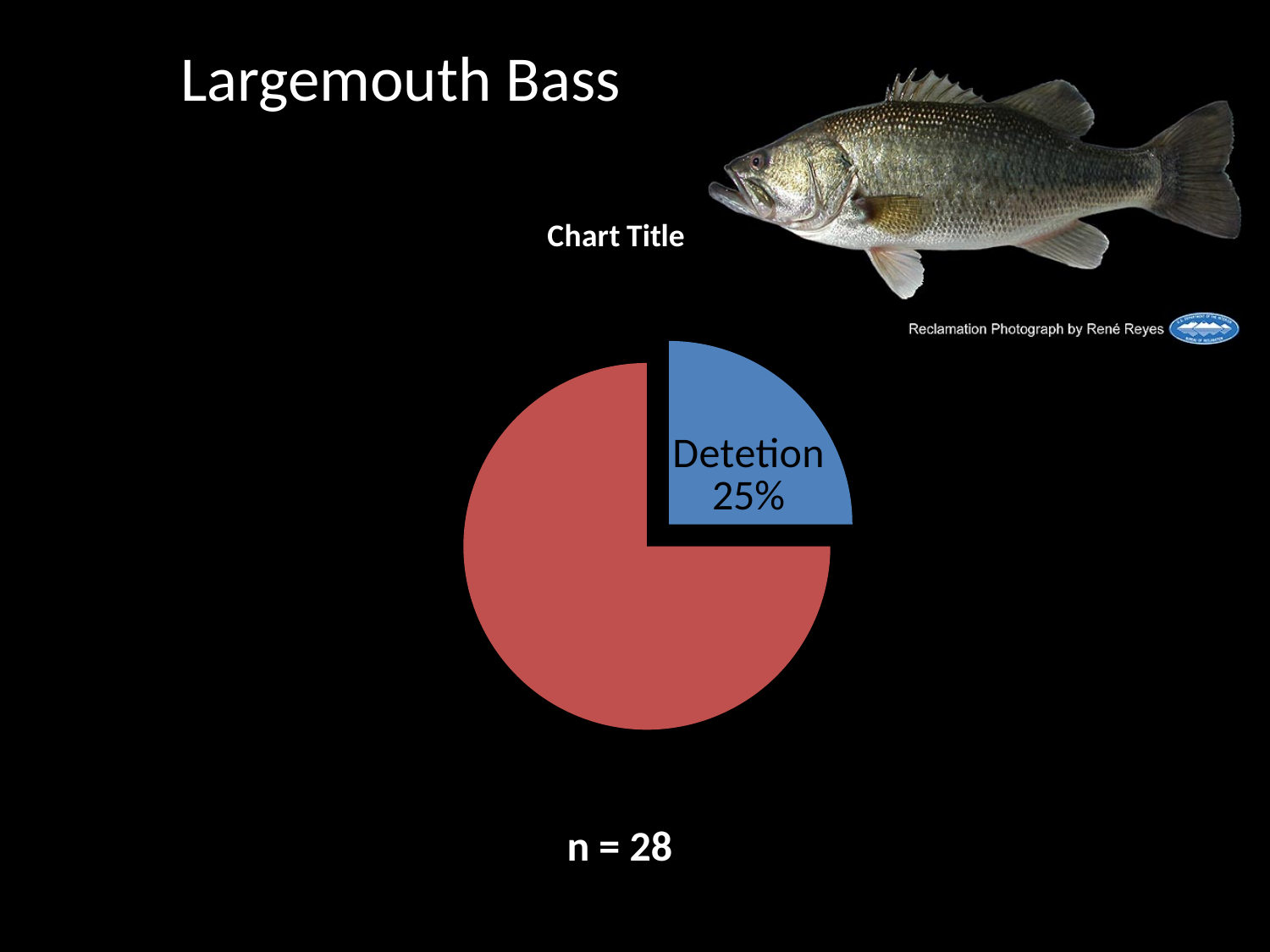
What share of the pie does the Detetion slice represent? 25% What kind of chart is shown on the slide? pie chart Is the share of the Detetion slice greater or less than 50%? less What share of the pie does the red (unlabeled) slice represent? 75% Which slice of the pie chart is the smallest? Detetion What is the title printed above the pie chart? Chart Title What colour is the Detetion slice of the pie chart? blue Which slice of the pie is larger, the blue Detetion slice or the red slice? the red slice How many slices does the pie chart have? 2